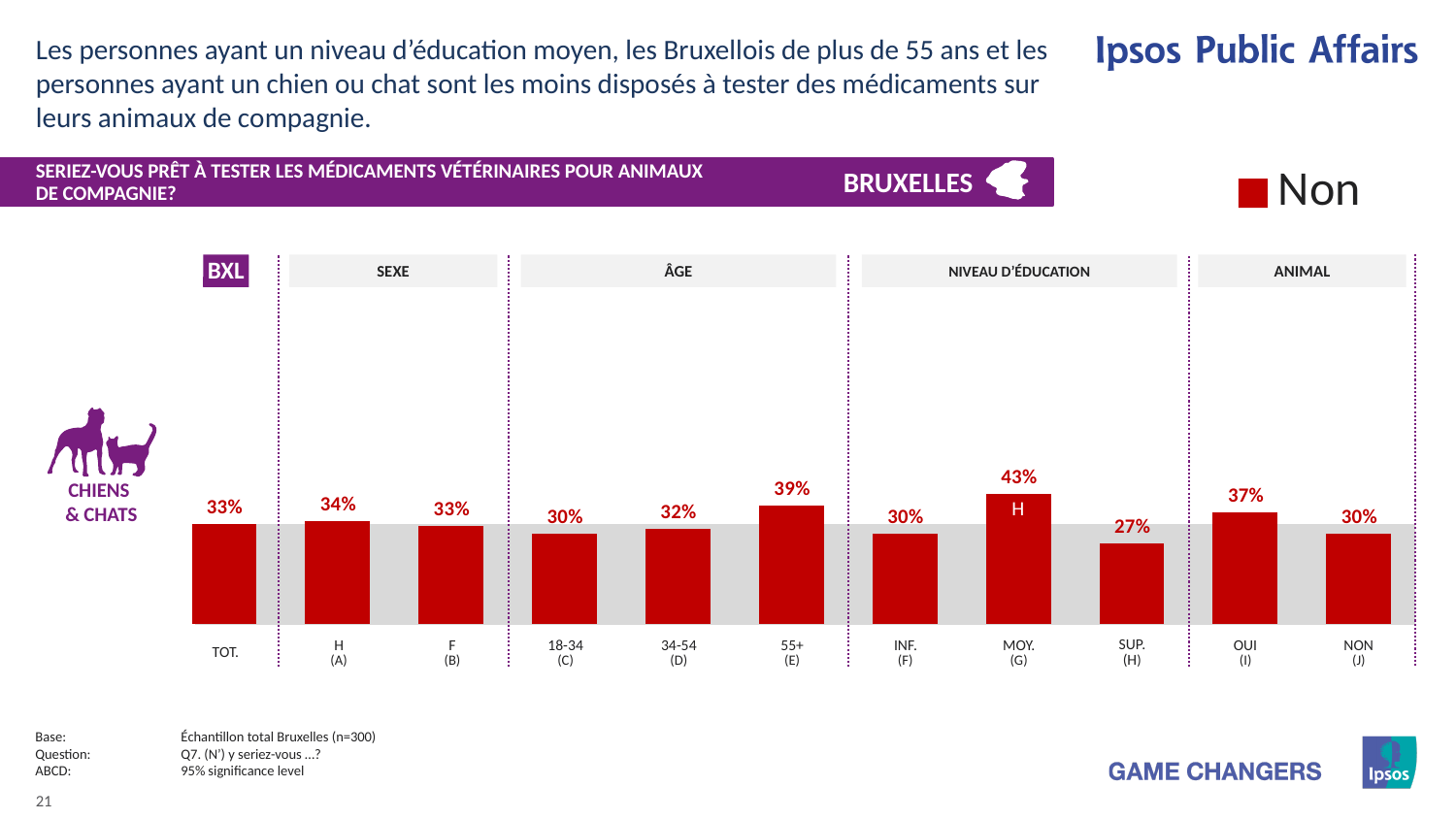
What is the value for the TOT. bar? 33% What is the value for OUI (I) under Animal? 37% What is the value for the 55+ age group? 39% Which category has the highest value on the chart? MOY. (G) What is the value for MOY. (G) under Niveau d'éducation? 43% Which is larger, the value for H (A) or the value for SUP. (H)? H (A) Which category has the lowest value on the chart? SUP. (H) How many bars are plotted on the chart? 11 What is the difference between the values for 55+ (E) and 18-34 (C)? 9% What kind of chart is shown on the slide? Bar chart What is the single legend entry shown for the chart? Non What is the difference between the values for OUI (I) and NON (J)? 7%